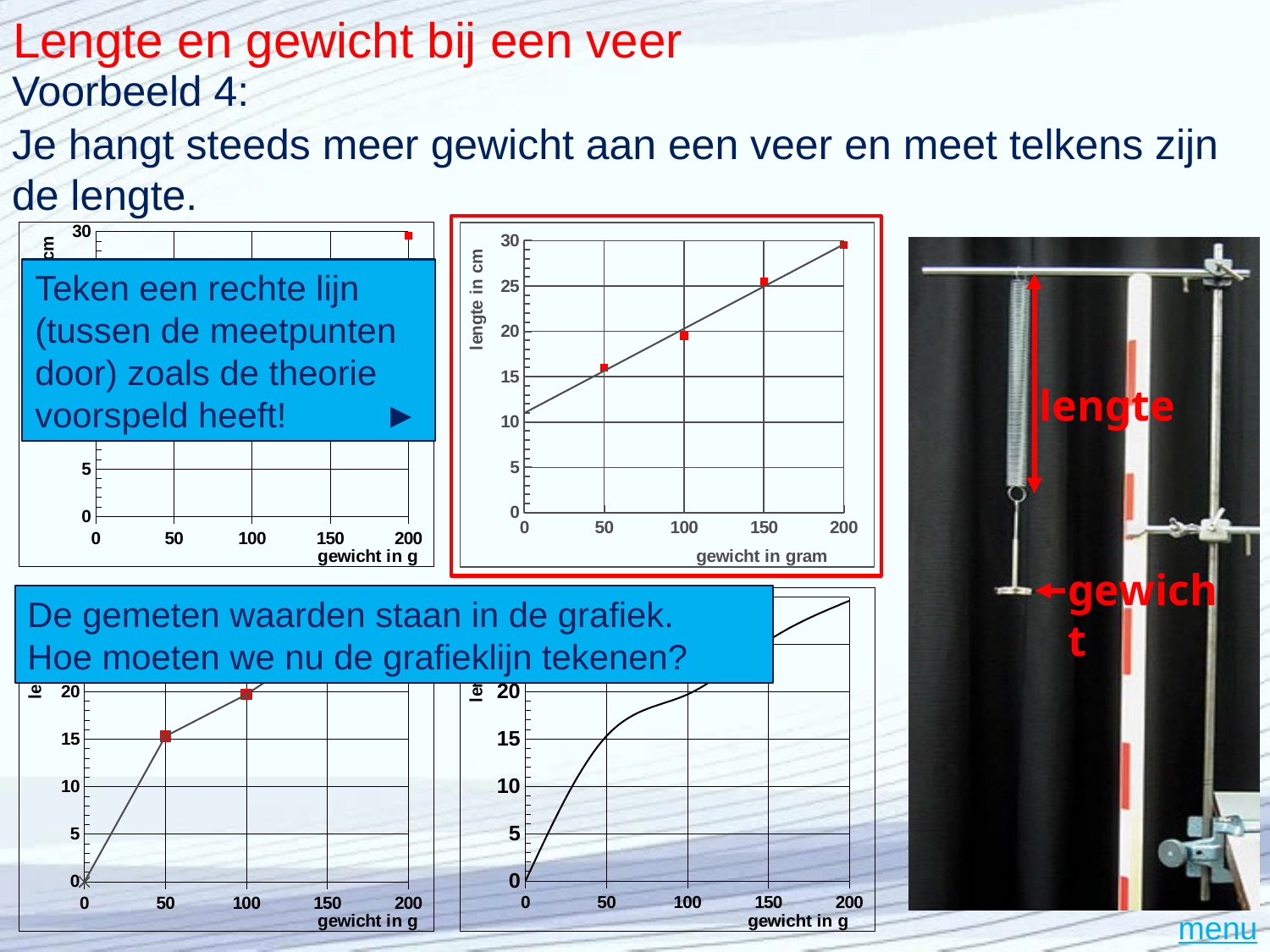
In the red-bordered chart, is the lengte at 50 gram greater or less than 20 cm? less In the red-bordered chart, is the lengte at 200 gram greater or less than 25 cm? greater In the red-bordered chart, what is the label on the horizontal axis? gewicht in gram In the red-bordered chart, how many measured data points are plotted? 4 In the red-bordered chart, what is the label on the vertical axis? lengte in cm In the red-bordered chart, which has the larger lengte: the point at 150 gram or the point at 100 gram? 150 gram In the red-bordered chart, do the lengte values rise or fall as gewicht increases? rise In the red-bordered chart, at which gewicht is the measured lengte lowest? 50 In the red-bordered chart, at which gewicht is the measured lengte highest? 200 In the red-bordered chart, is the lengte at 100 gram greater or less than 15 cm? greater